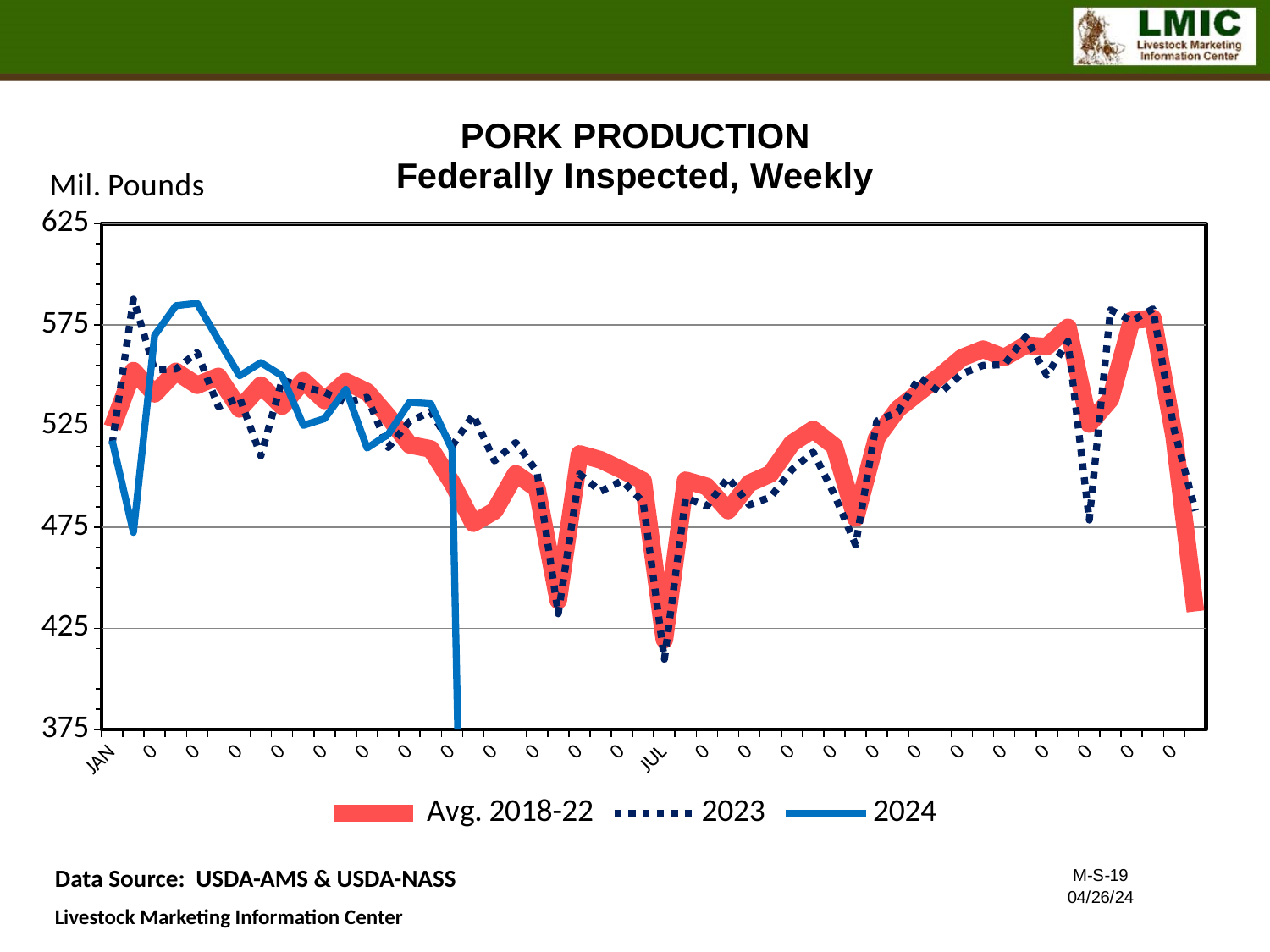
What unit is shown on the y axis of the chart? Mil. Pounds Is the final value of the Avg. 2018-22 line at the end of the year greater or less than 475? less Is the early-year dip of the 2024 line greater or less than 500? less What kind of chart is shown on the slide? line chart Is the lowest value of the Avg. 2018-22 line near JUL greater or less than 425? less What is the title of the chart? PORK PRODUCTION Federally Inspected, Weekly Which series reaches a higher peak in the first quarter of the year, 2024 or Avg. 2018-22? 2024 How many series does the legend list? 3 Does the Avg. 2018-22 line generally rise or fall from JUL through the autumn months? rise